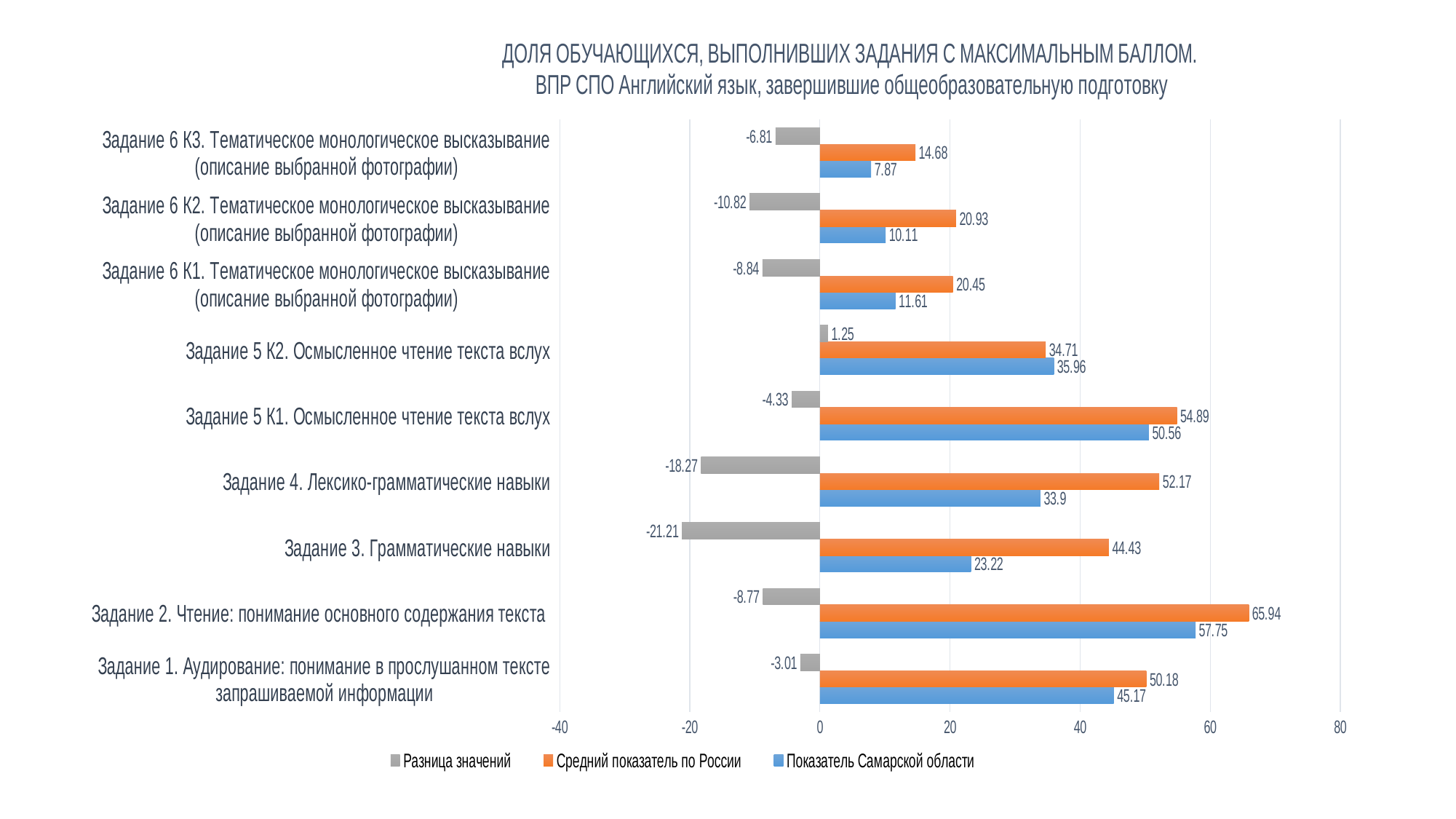
What is the value of Средний показатель по России for Задание 3. Грамматические навыки? 44.43 For Задание 5 К2. Осмысленное чтение текста вслух, which is larger: Средний показатель по России or Показатель Самарской области? Показатель Самарской области Which task has the lowest value for Показатель Самарской области? Задание 6 К3. Тематическое монологическое высказывание (описание выбранной фотографии) Which task has the lowest (most negative) value for Разница значений? Задание 3. Грамматические навыки How many series does the legend list? 3 What is the difference between Средний показатель по России and Показатель Самарской области for Задание 2. Чтение: понимание основного содержания текста? 8.19 What kind of chart is shown on the slide? Bar chart Which task has the highest value for Средний показатель по России? Задание 2. Чтение: понимание основного содержания текста What is the value of Показатель Самарской области for Задание 2. Чтение: понимание основного содержания текста? 57.75 What is the value of Разница значений for Задание 4. Лексико-грамматические навыки? -18.27 What is the value of Показатель Самарской области for Задание 6 К1. Тематическое монологическое высказывание? 11.61 How many tasks (categories) are shown on the chart? 9